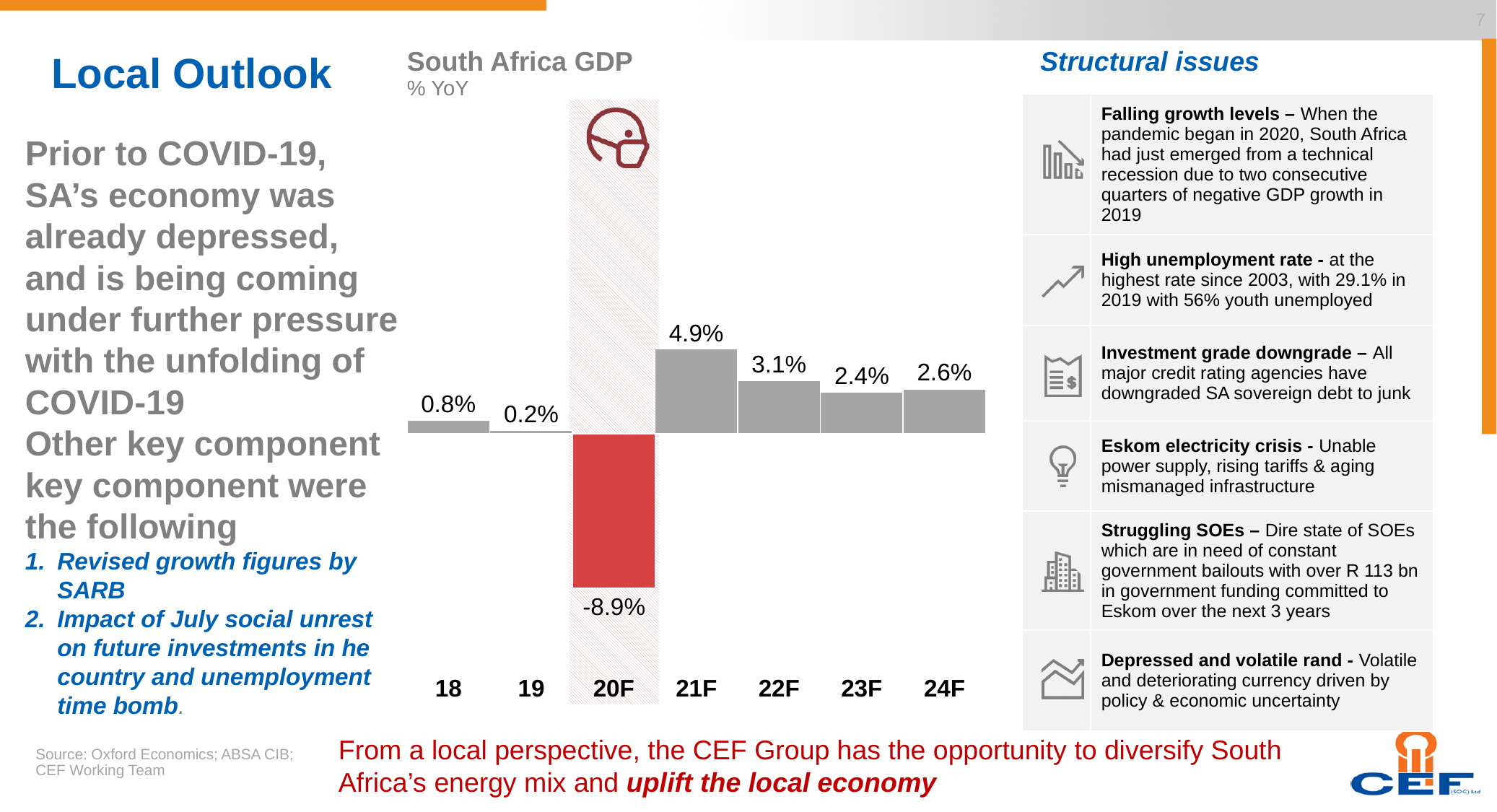
Do the GDP growth values rise or fall from 21F to 23F? Fall Which year has the highest GDP growth value in the South Africa GDP chart? 21F What is the South Africa GDP growth value shown for 21F? 4.9% What is the South Africa GDP growth value shown for 20F? -8.9% What kind of chart is the South Africa GDP chart? Bar chart Which has the larger GDP growth value, 23F or 24F? 24F What unit is given in the subtitle of the South Africa GDP chart? % YoY Which year has the lowest GDP growth value in the South Africa GDP chart? 20F What is the difference between the GDP growth values for 21F and 22F? 1.8% What is the South Africa GDP growth value shown for 18? 0.8% How many years are shown on the x axis of the South Africa GDP chart? 7 What is the South Africa GDP growth value shown for 23F? 2.4%